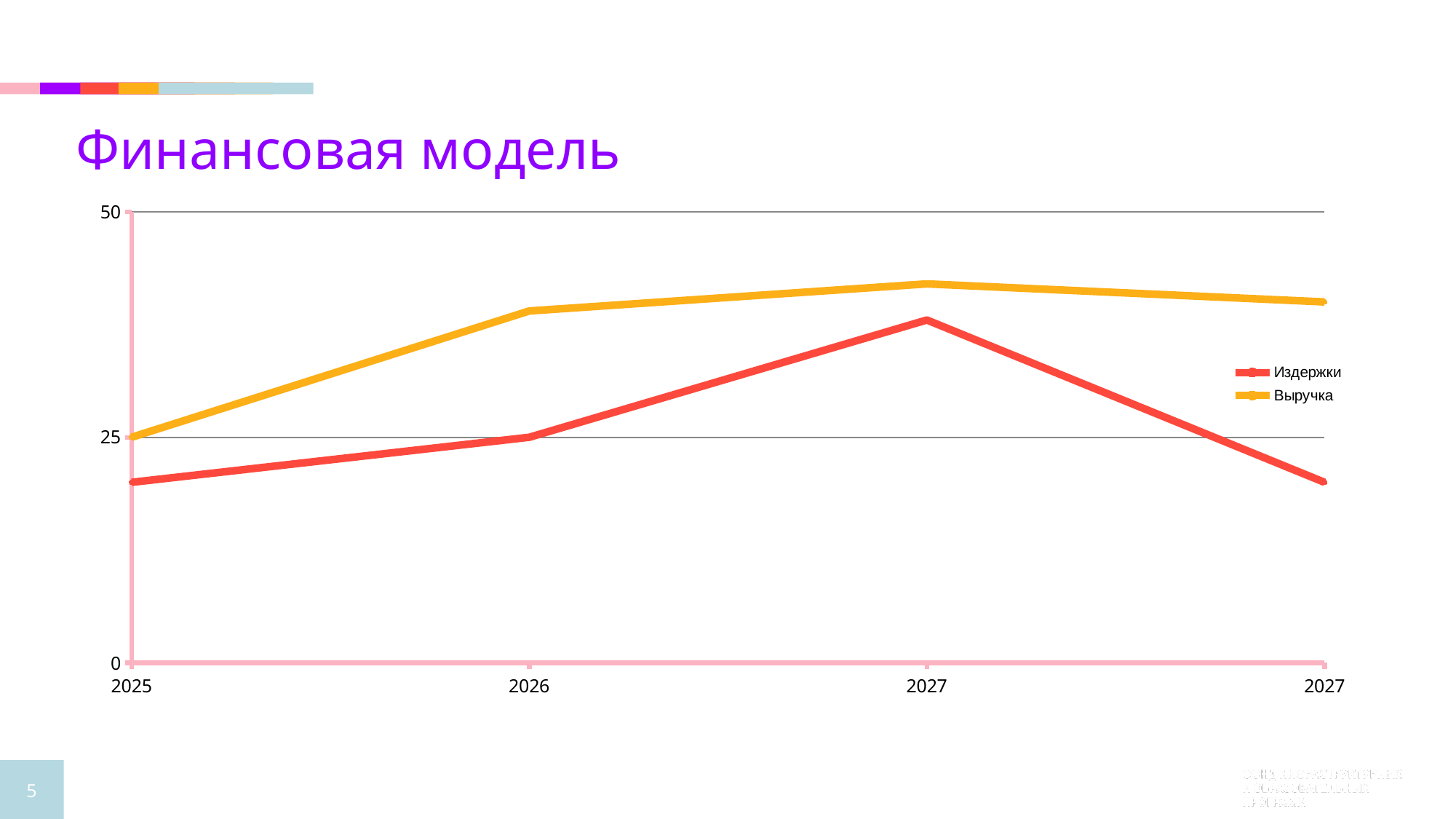
Does the Выручка line rise or fall from 2025 to 2026? rise How many series does the legend list? 2 What colour is the Издержки line in the legend? red Is the value for Выручка at the last point on the x axis greater or less than 50? less Is the value for Издержки in 2025 greater or less than 25? less What kind of chart is shown on the slide? line chart What is the value of Издержки in 2026? 25 How many points are plotted along the x axis for each series? 4 What is the value of Выручка in 2025? 25 Is the value for Выручка in 2026 greater or less than 25? greater Which series is higher at every point on the chart? Выручка Which series has the larger value in 2026, Издержки or Выручка? Выручка